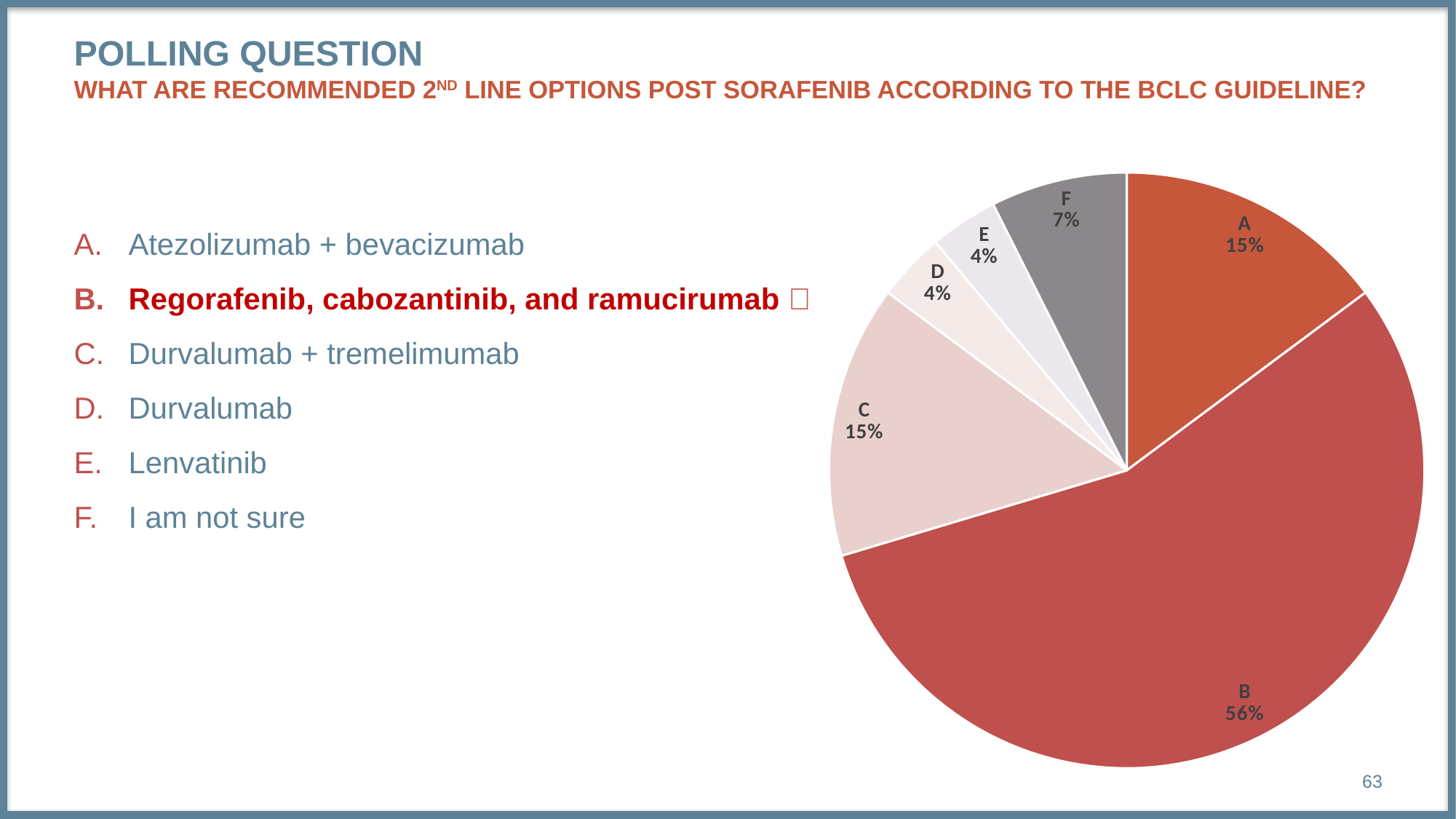
Which is larger, slice A or slice F? A Which answer option is highlighted in bold red as the correct answer on the slide? B What is the difference in percentage points between slice B and slice C? 41 What percentage of responses does slice F represent? 7% What is the difference in percentage points between slice F and slice E? 3 What percentage of responses does slice A represent? 15% Which slice of the pie chart is the largest? B What percentage of responses does slice D represent? 4% How many slices does the pie chart have? 6 What percentage of responses does slice B represent? 56% Which is larger, slice F or slice D? F What kind of chart is shown on the slide? pie chart